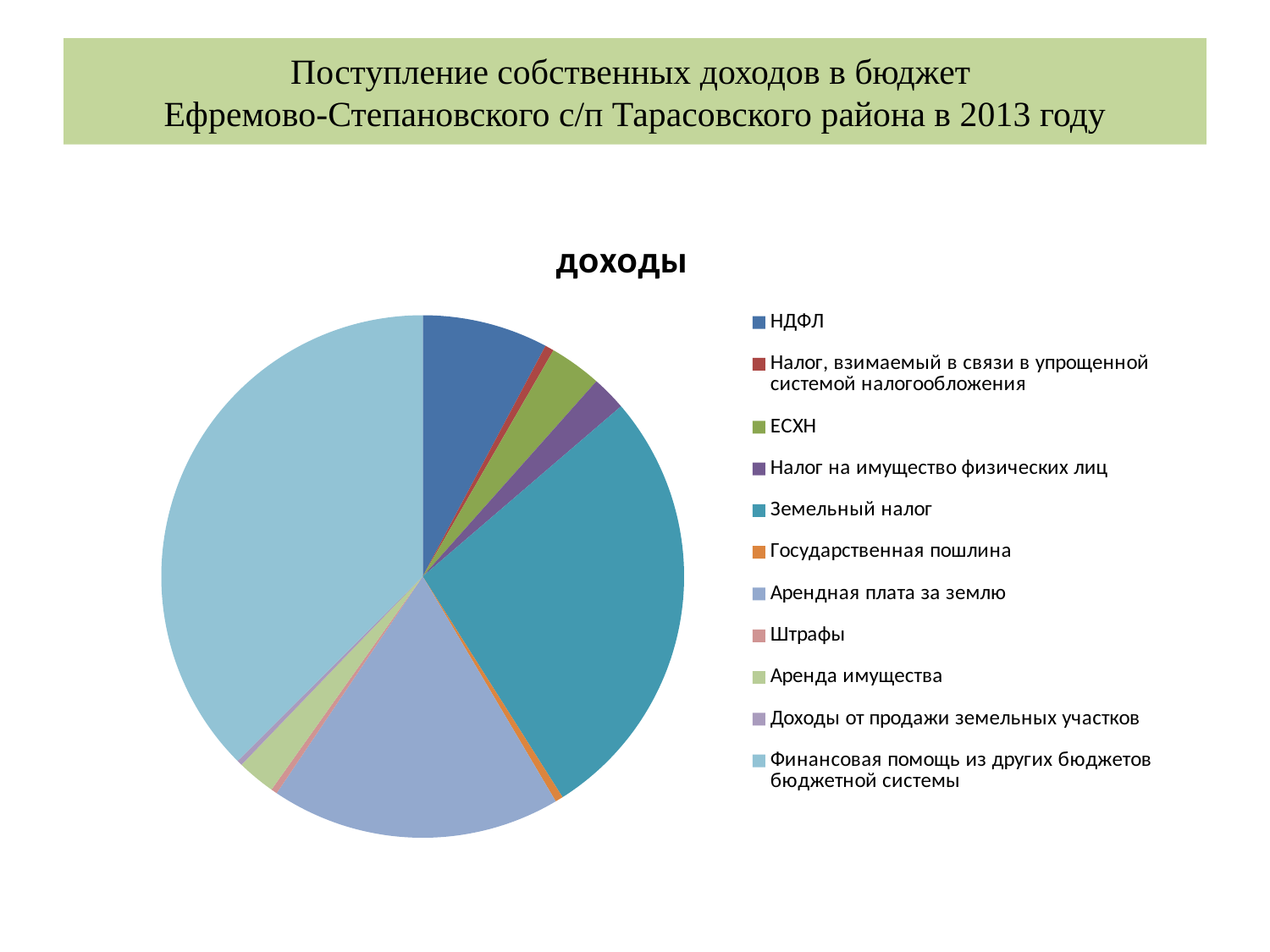
How many categories does the legend of the pie chart list? 11 Which slice is larger: Финансовая помощь из других бюджетов бюджетной системы or Земельный налог? Финансовая помощь из других бюджетов бюджетной системы Which category has the largest slice of the pie? Финансовая помощь из других бюджетов бюджетной системы Which slice is larger: Земельный налог or Арендная плата за землю? Земельный налог Which slice is larger: НДФЛ or ЕСХН? НДФЛ What kind of chart is shown on the slide? pie chart What is the first category listed in the legend? НДФЛ What is the title of the chart? доходы